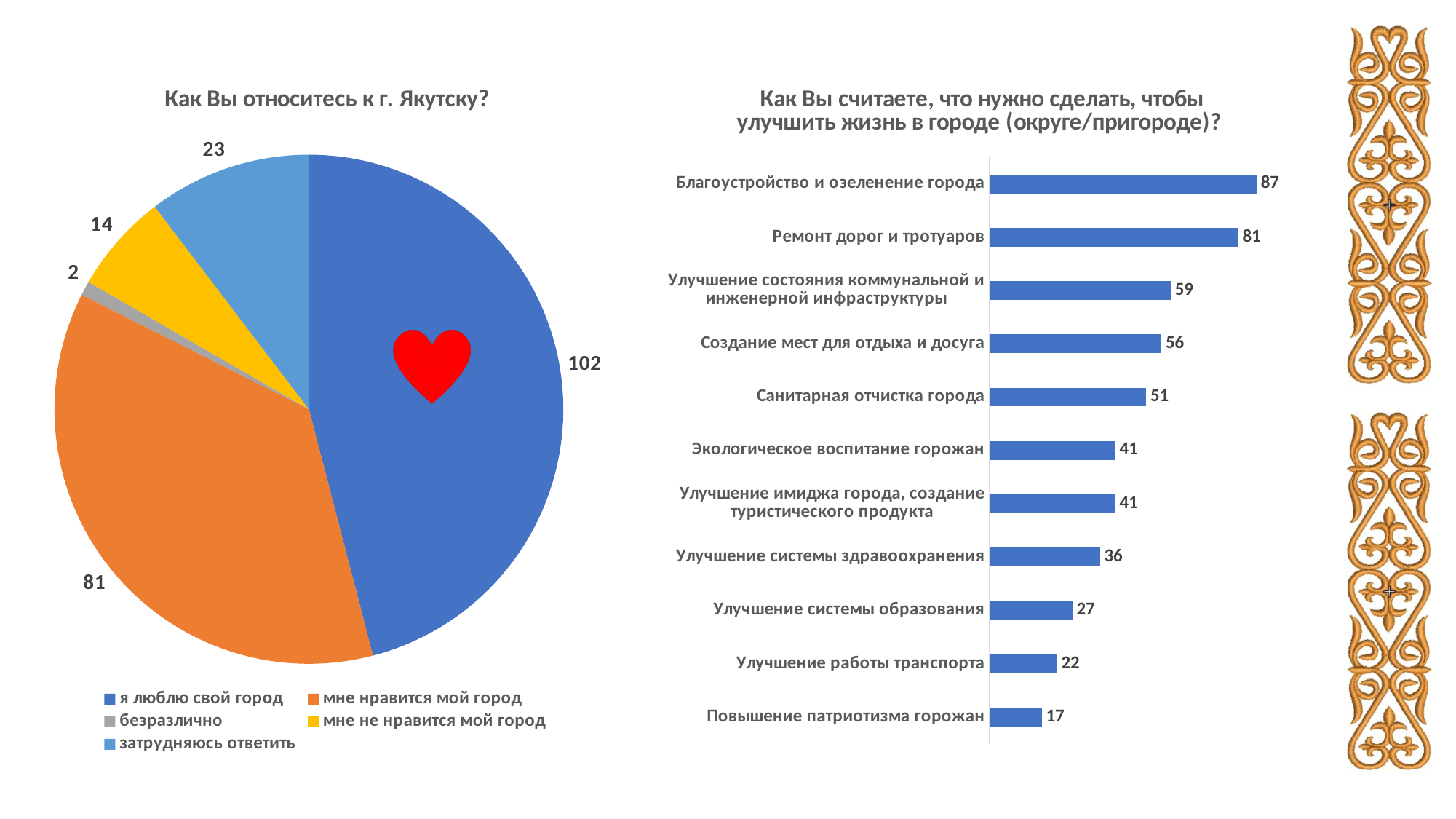
In the pie chart "Как Вы относитесь к г. Якутску?", what colour is the slice for "мне не нравится мой город"? Yellow In the pie chart "Как Вы относитесь к г. Якутску?", which is larger: "затрудняюсь ответить" or "мне не нравится мой город"? затрудняюсь ответить In the bar chart on the right, what is the value for "Ремонт дорог и тротуаров"? 81 In the bar chart on the right, which category has the highest value? Благоустройство и озеленение города In the bar chart on the right, how many categories are shown? 11 What kind of chart is the one on the right, titled "Как Вы считаете, что нужно сделать, чтобы улучшить жизнь в городе (округе/пригороде)?"? Bar chart In the bar chart on the right, which category has the lowest value? Повышение патриотизма горожан In the pie chart "Как Вы относитесь к г. Якутску?", how many categories does the legend list? 5 In the bar chart on the right, what is the difference between "Санитарная отчистка города" and "Улучшение работы транспорта"? 29 In the pie chart "Как Вы относитесь к г. Якутску?", what is the value for "я люблю свой город"? 102 In the pie chart "Как Вы относитесь к г. Якутску?", which category has the smallest slice? безразлично In the pie chart "Как Вы относитесь к г. Якутску?", what is the difference between "я люблю свой город" and "мне нравится мой город"? 21